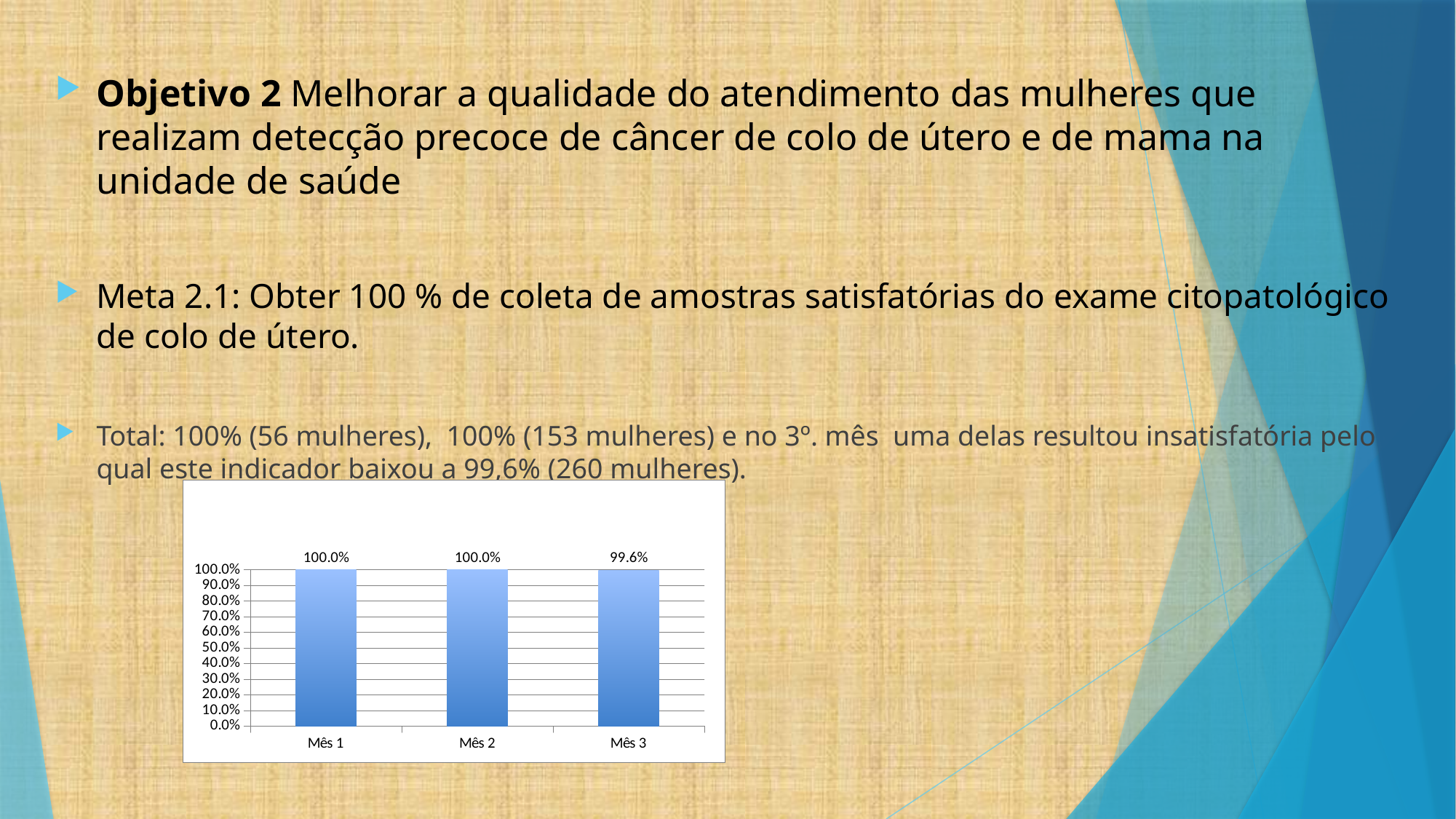
What is the value for Mês 1? 100.0% What is the value for Mês 3? 99.6% Is the value for Mês 3 greater or less than 90.0%? greater Do the values rise or fall from Mês 1 to Mês 3? fall What is the highest tick label on the y axis? 100.0% What is the label of the first category on the x axis? Mês 1 Which is larger, the value for Mês 2 or the value for Mês 3? Mês 2 How many categories are shown on the x axis? 3 Which month has the lowest value? Mês 3 What is the difference between the values for Mês 1 and Mês 3? 0.4% What is the value for Mês 2? 100.0% What kind of chart is shown on the slide? bar chart